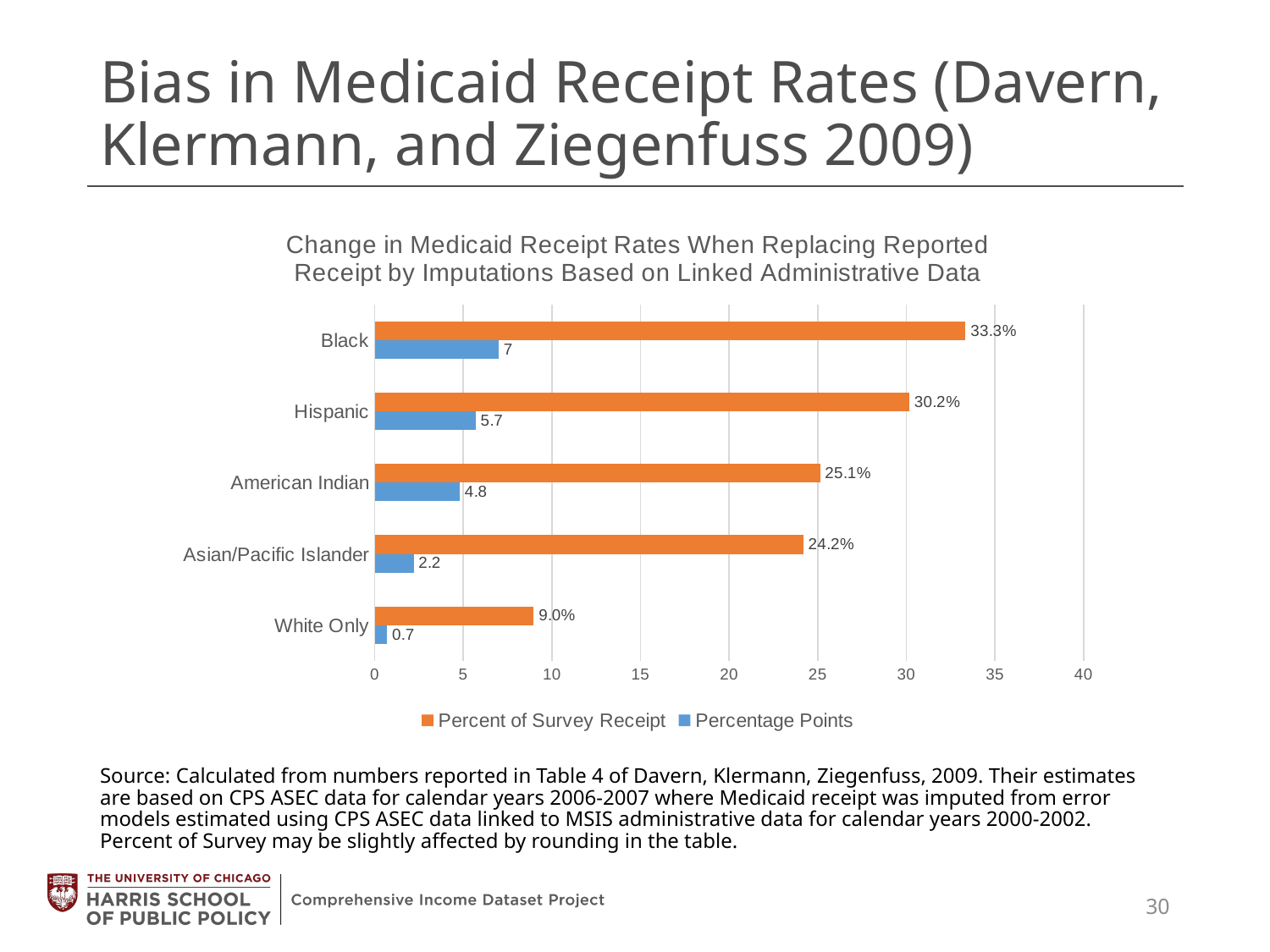
What is the difference between the Percent of Survey Receipt values for Black and Hispanic? 3.1% What is the Percent of Survey Receipt value for Black? 33.3% How many series does the legend list? 2 What is the Percentage Points value for Hispanic? 5.7 What is the Percentage Points value for Asian/Pacific Islander? 2.2 What is the Percent of Survey Receipt value for White Only? 9.0% Which category has the lowest Percentage Points value? White Only How many categories are shown on the chart? 5 Which colour represents the Percentage Points series? Blue What kind of chart is shown on the slide? Bar chart Which category has the highest Percent of Survey Receipt value? Black Which is larger, the Percentage Points value for American Indian or for Asian/Pacific Islander? American Indian